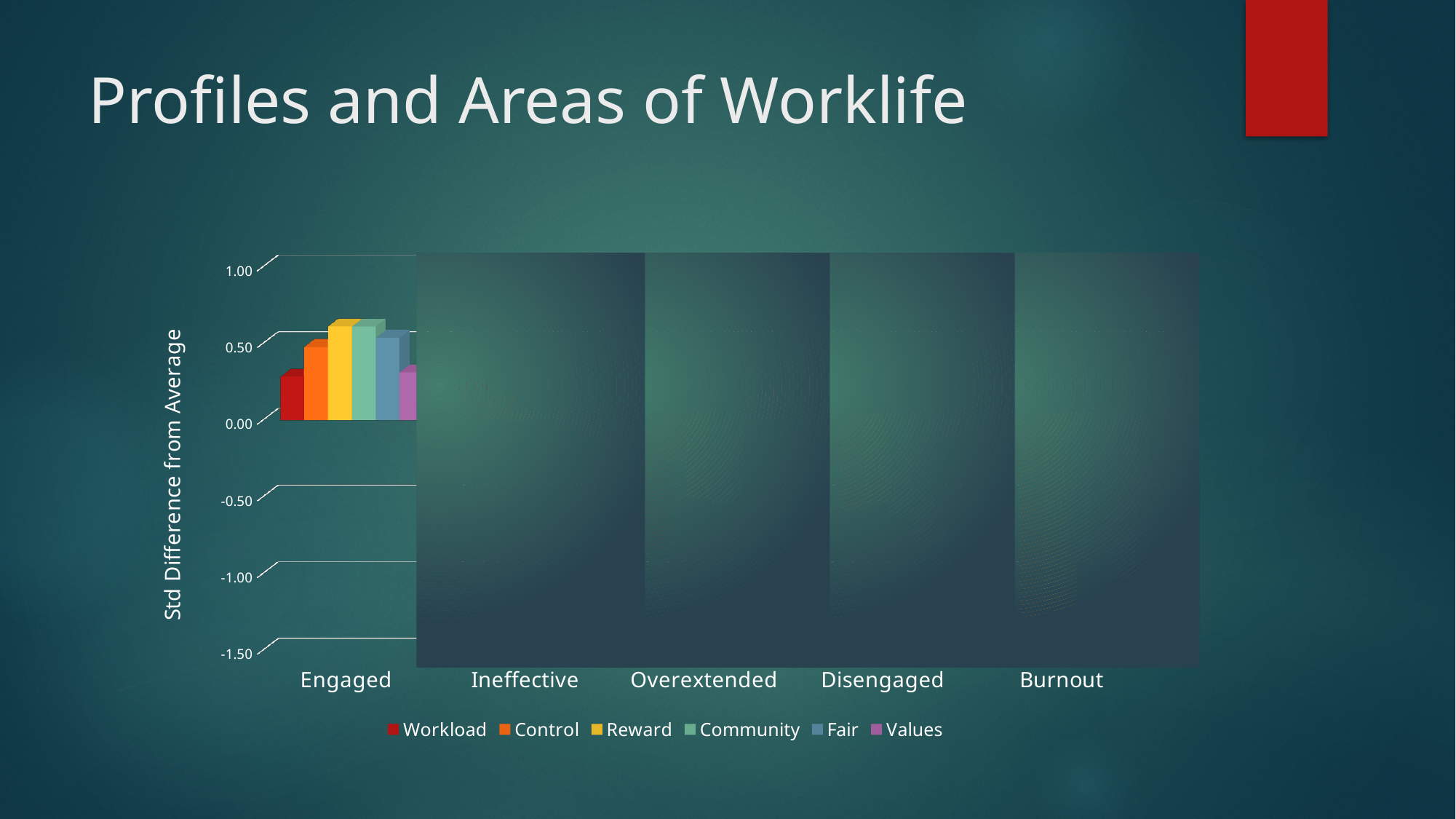
Is the Workload value for Engaged greater or less than 0.50? less Is the Community value for Engaged greater or less than 0.50? greater Which series is listed first in the legend? Workload What kind of chart is shown on the slide? bar chart How many profile categories are labelled along the x axis? 5 What is the title of the vertical axis? Std Difference from Average For the Engaged profile, which is larger: Control or Workload? Control Is the Reward value for Engaged greater or less than 0.50? greater For the Engaged profile, which is larger: Reward or Workload? Reward How many series does the legend list? 6